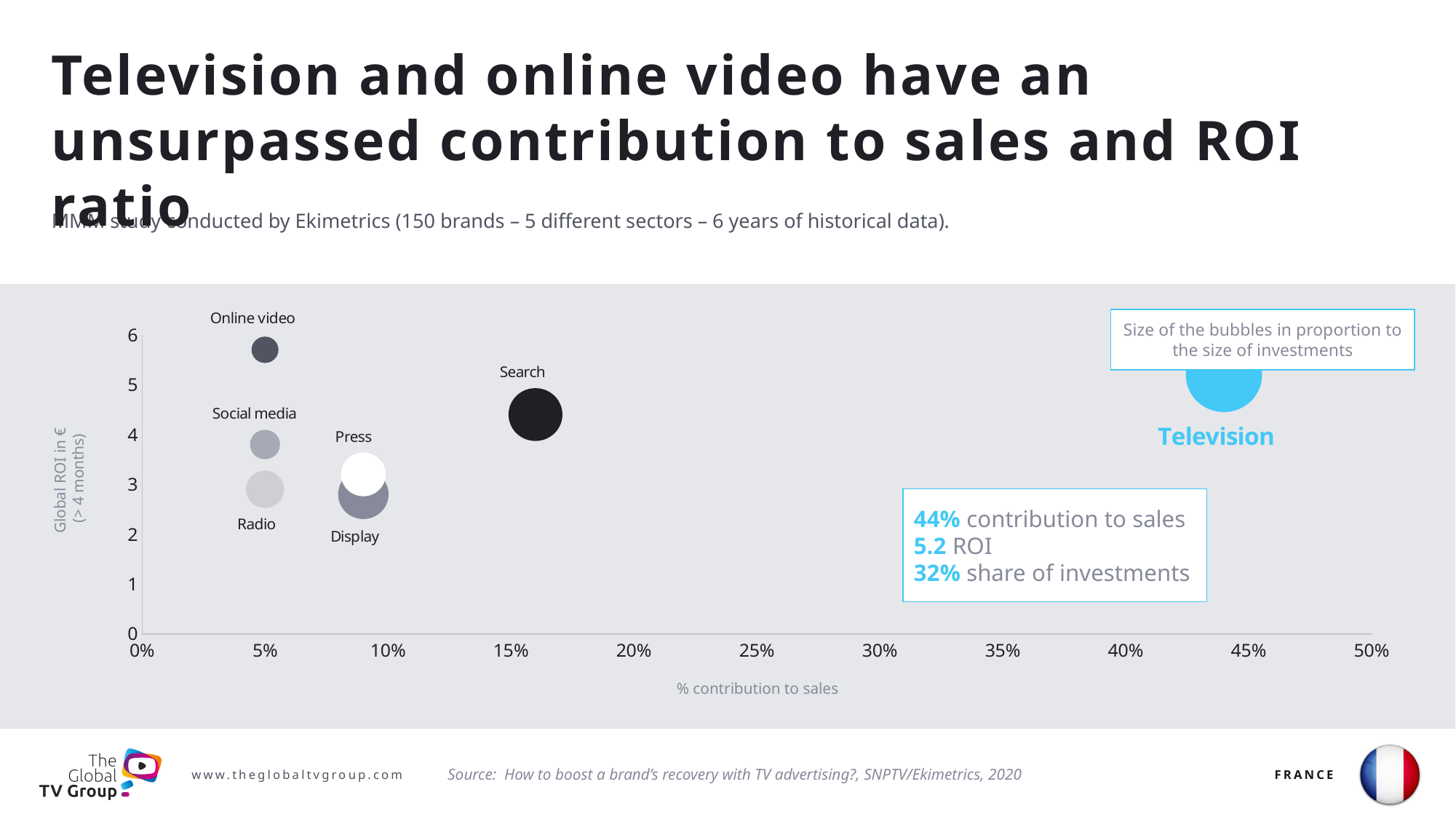
What is Television's share of investments? 32% What kind of chart is shown on the slide? Bubble chart Is the Global ROI for Radio greater or less than 4? less Which has a larger % contribution to sales, Search or Online video? Search Is the Global ROI for Online video greater or less than 5? greater What does the size of the bubbles represent? The size of investments What is the % contribution to sales for Television? 44% What is the ROI for Television? 5.2 How many media channels are plotted as bubbles on the chart? 7 Is the % contribution to sales for Search greater or less than 20%? less Which has a higher Global ROI, Television or Search? Television Which channel has the highest % contribution to sales? Television